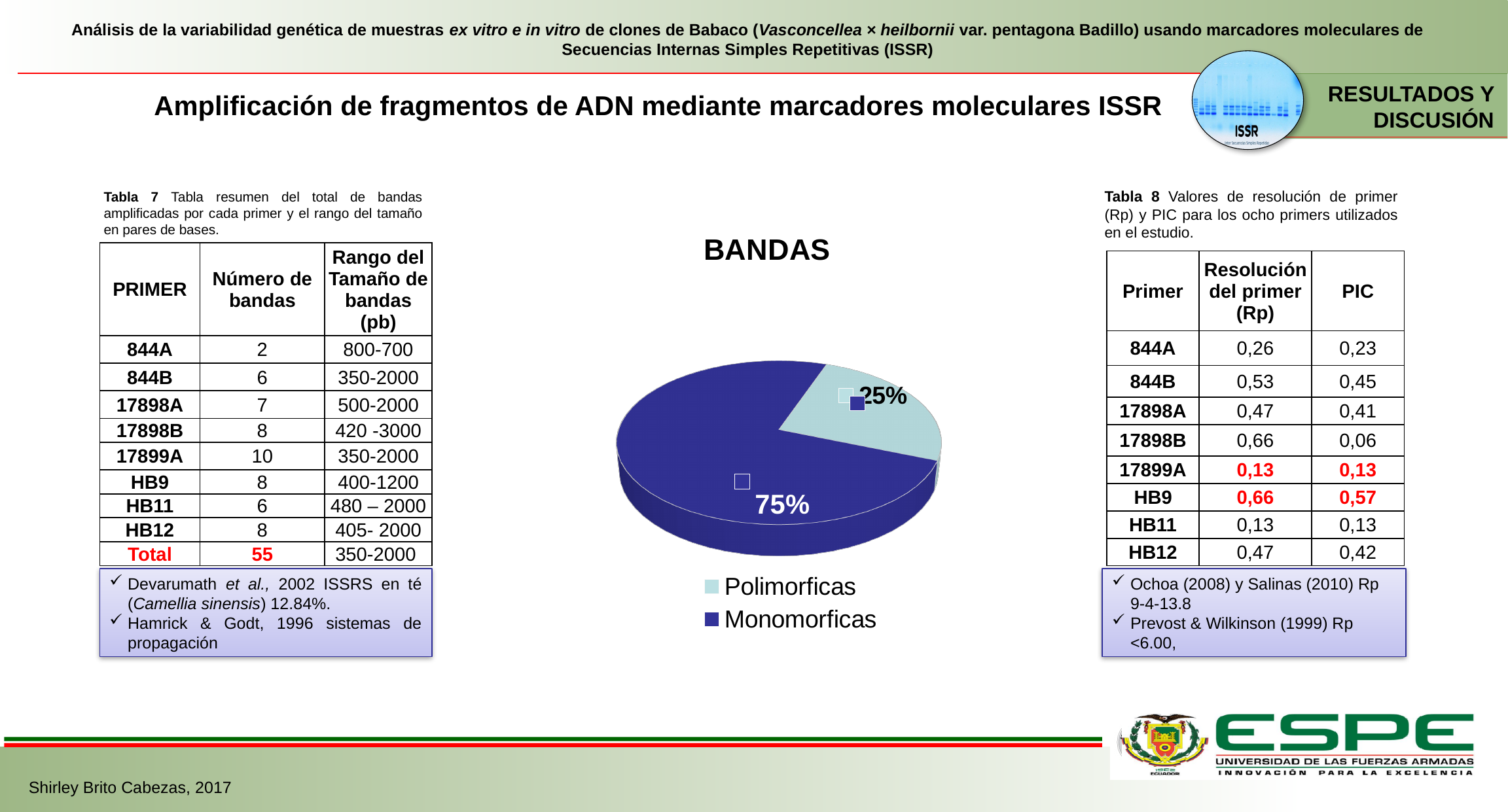
Which slice of the pie chart is the largest? Monomorficas What share of the pie does Monomorficas represent? 75% Which legend entry is shown in dark blue in the pie chart? Monomorficas What is the title of the pie chart? BANDAS How many slices does the pie chart have? 2 What kind of chart is shown in the centre of the slide? pie chart Which is larger in the pie chart, Polimorficas or Monomorficas? Monomorficas What is the difference in percentage points between the Monomorficas and Polimorficas slices? 50% How many entries does the legend of the pie chart list? 2 What share of the pie does Polimorficas represent? 25% Which slice of the pie chart is the smallest? Polimorficas